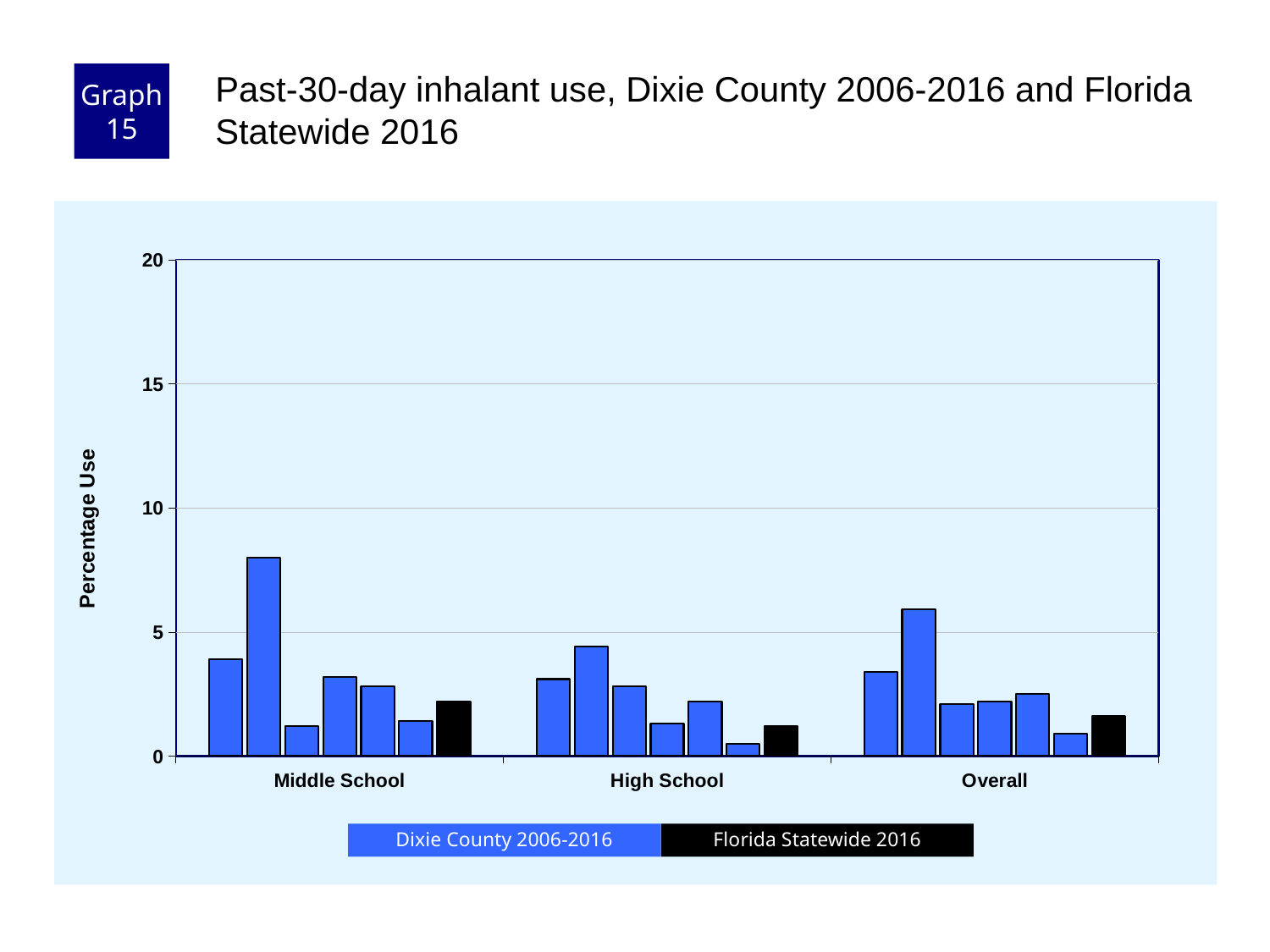
Is the Florida Statewide 2016 value larger for Middle School or for High School? Middle School Is the highest value anywhere on the chart greater or less than 10? less What kind of chart is shown on the slide? bar chart Is the tallest bar in the Overall group greater or less than 5? greater How many school-level categories are shown on the x axis? 3 What is the label on the y axis? Percentage Use How many series does the legend list? 2 Which group contains the tallest bar on the chart? Middle School Is the tallest bar in the Middle School group greater or less than 5? greater What are the two series named in the legend? Dixie County 2006-2016 and Florida Statewide 2016